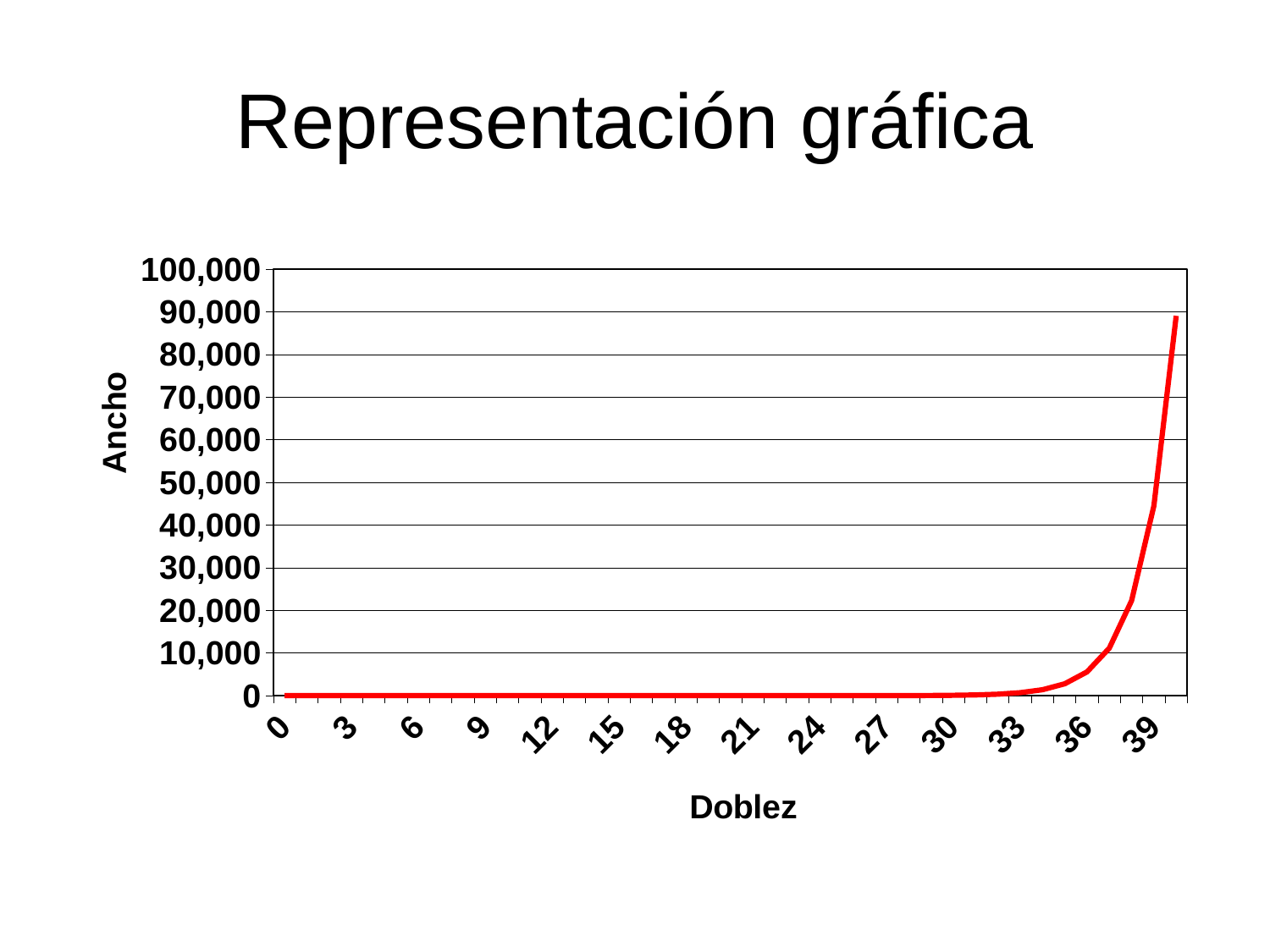
What is the highest value shown on the y axis? 100,000 What kind of chart is shown on the slide? Line chart What is the title of the slide? Representación gráfica Is the highest value plotted on the chart greater or less than 80,000? greater Is the highest value plotted on the chart greater or less than 100,000? less Is the value for Doblez 39 greater or less than 10,000? greater What is the label of the x axis? Doblez Which is larger, the value for Doblez 39 or the value for Doblez 33? Doblez 39 How many lines are plotted on the chart? 1 Do the values rise or fall as Doblez increases along the x axis? Rise